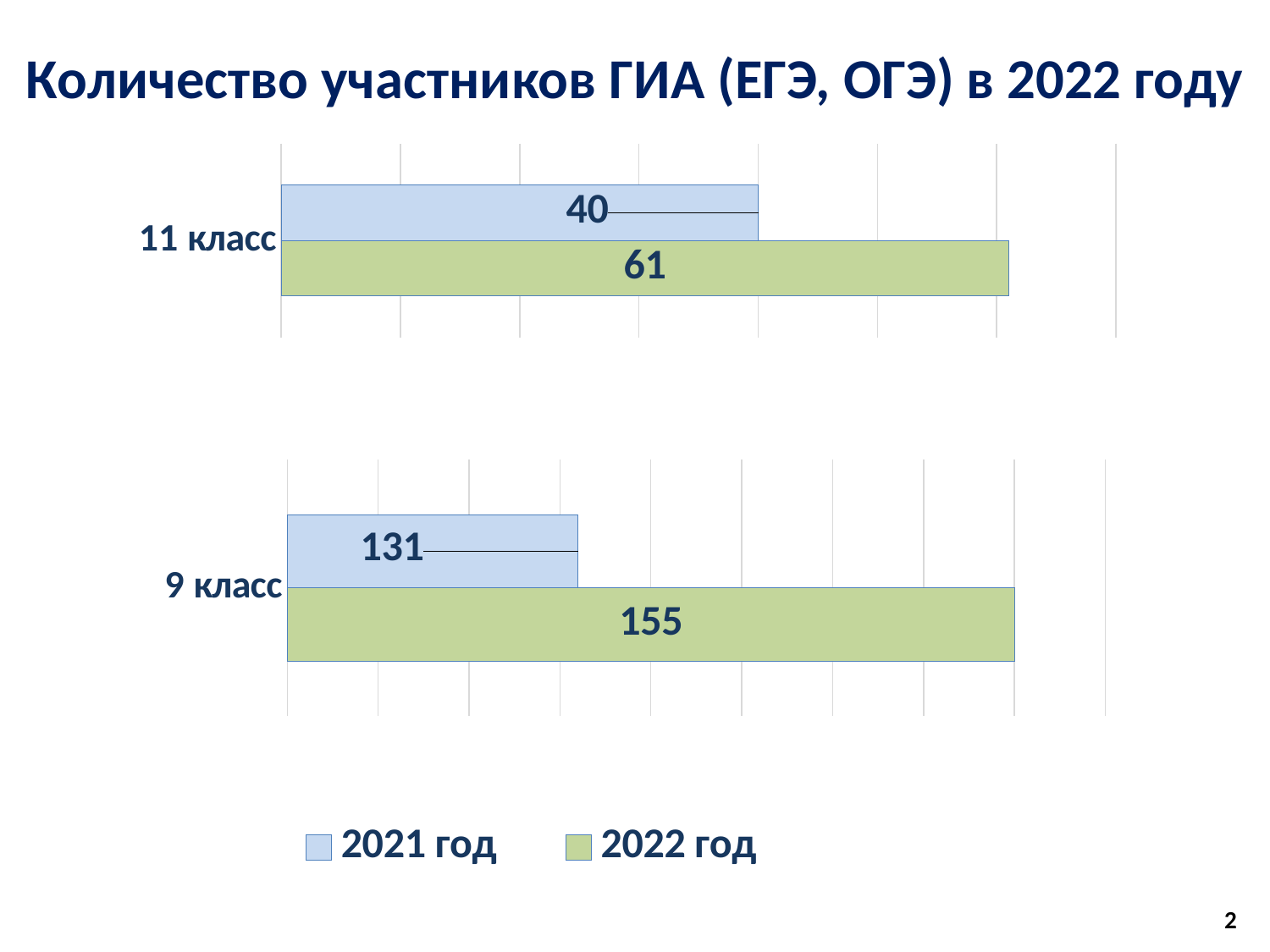
For 11 класс, which series has the larger value, 2021 год or 2022 год? 2022 год What is the difference between the 2022 год and 2021 год values for 9 класс? 24 What is the difference between the 2022 год and 2021 год values for 11 класс? 21 What is the value for 11 класс in the 2022 год series? 61 What kind of chart is shown on the slide? Bar chart What is the value for 11 класс in the 2021 год series? 40 How many categories are shown on the chart? 2 How many series does the legend list? 2 Which category has the lowest value in the 2021 год series? 11 класс Which category has the highest value in the 2022 год series? 9 класс What is the value for 9 класс in the 2022 год series? 155 What is the value for 9 класс in the 2021 год series? 131